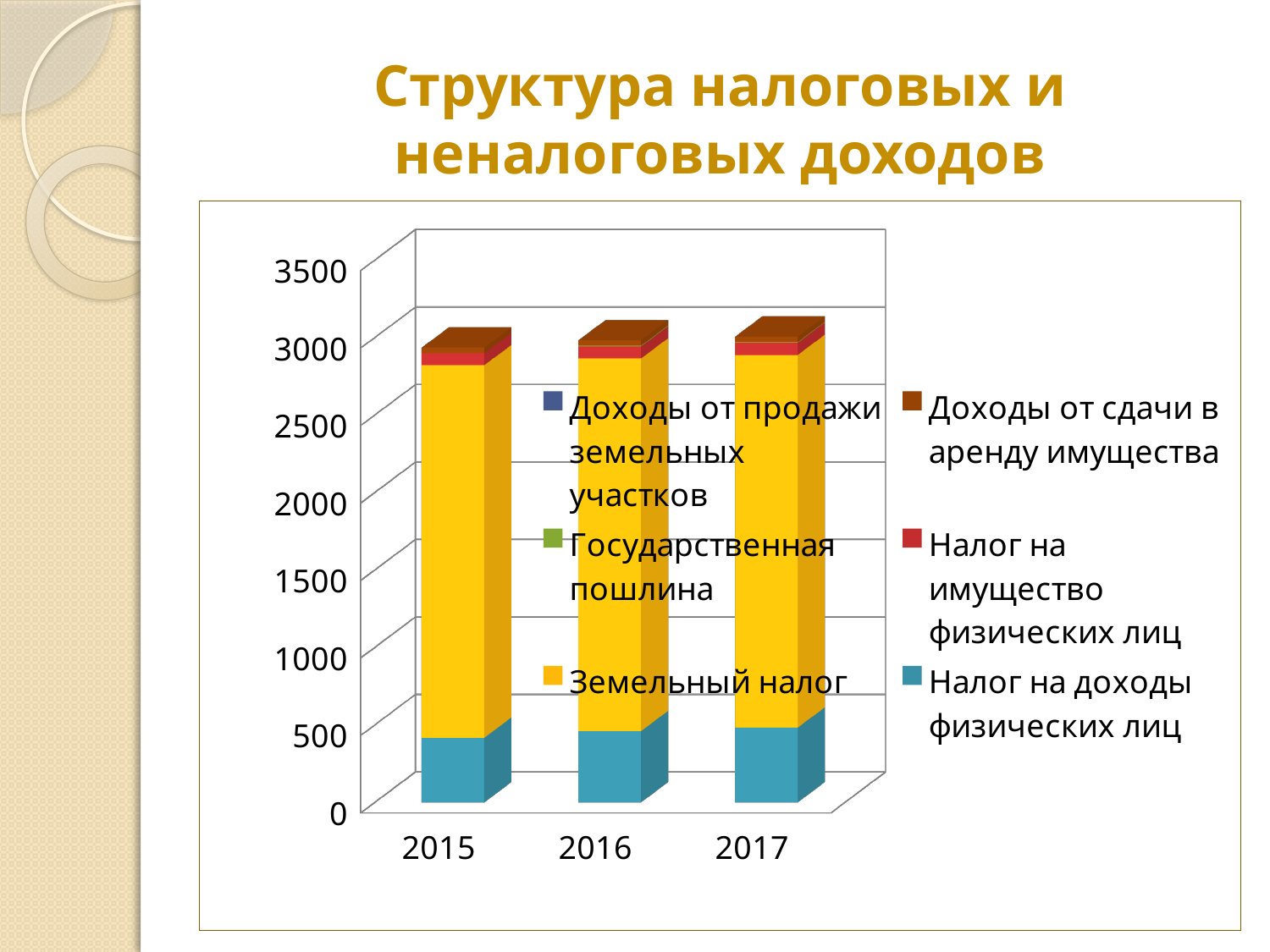
Is the value of Налог на доходы физических лиц for 2016 greater or less than 1000? less Which series occupies the largest segment of each stacked bar? Земельный налог What kind of chart is shown on the slide? stacked bar chart What is the title of the slide containing the chart? Структура налоговых и неналоговых доходов What is the highest value shown on the vertical axis? 3500 How many years (categories) are shown on the x axis of the chart? 3 Which year is the first category on the x axis? 2015 How many series does the chart's legend list? 6 Is the total height of the stacked bar for 2017 greater or less than 3500? less Is the total height of the stacked bar for 2016 greater or less than 2000? greater